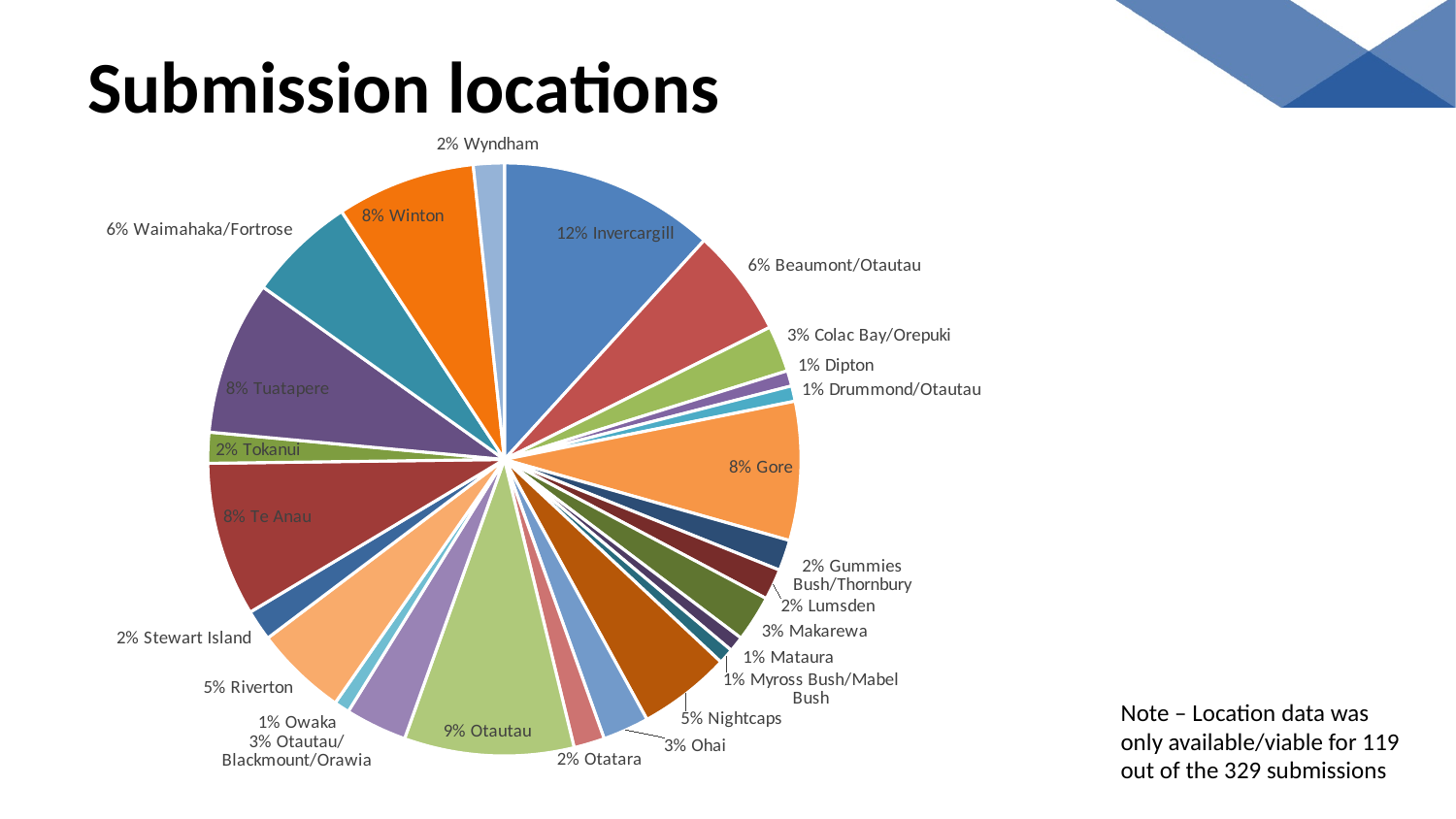
What kind of chart is shown on the slide? Pie chart What percentage is shown for Gore? 8% Which is larger, the share for Gore or the share for Nightcaps? Gore What share of submissions came from Invercargill? 12% What percentage is shown for Nightcaps? 5% What is the difference in percentage points between Invercargill and Otautau? 3 Which location has the largest share of submissions? Invercargill What percentage is shown for Otautau? 9% According to the note, for how many of the 329 submissions was location data available? 119 How many locations are shown in the pie chart? 25 What is the title of the chart? Submission locations What percentage is shown for Waimahaka/Fortrose? 6%